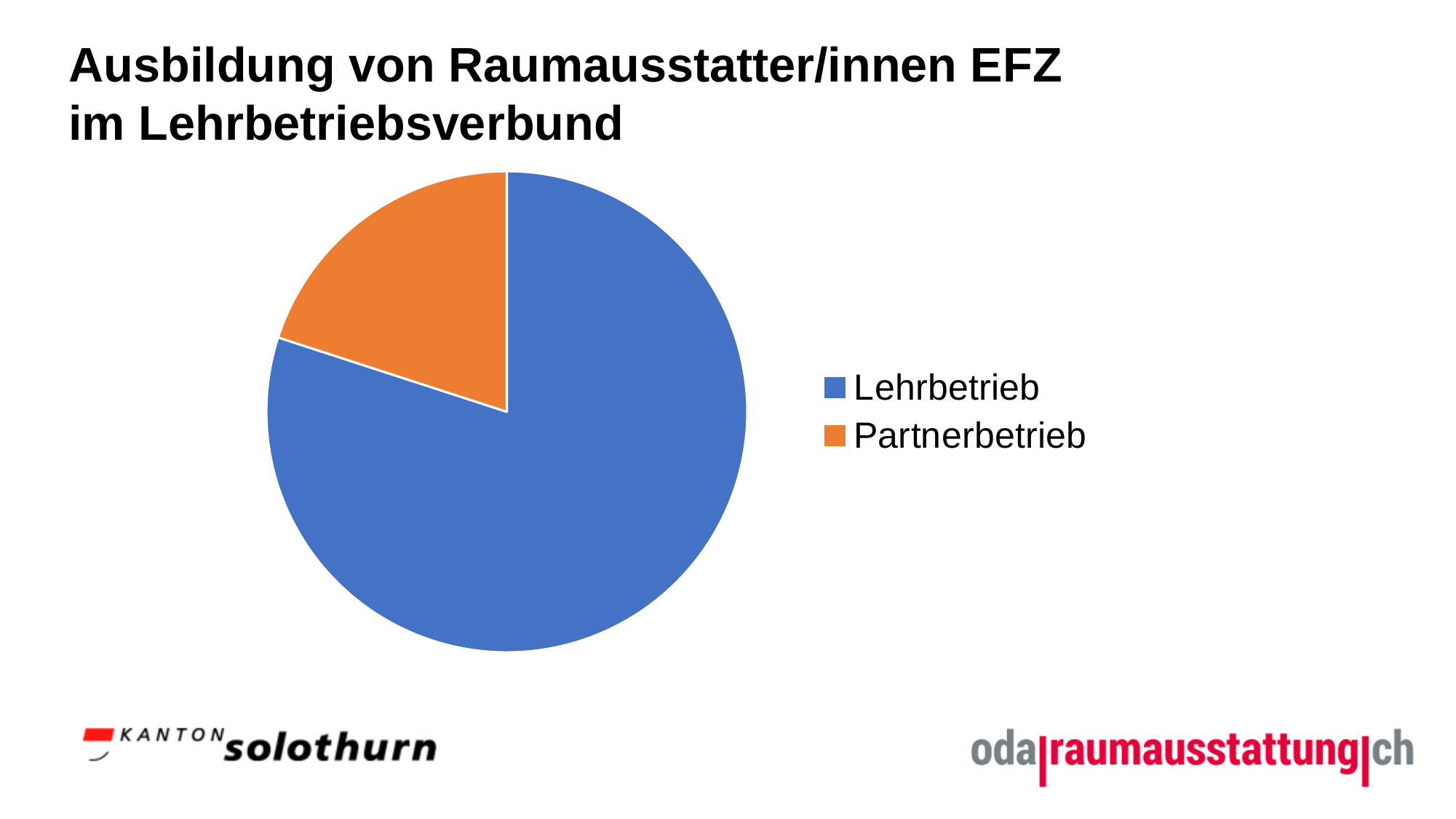
What kind of chart is shown on the slide? pie chart How many entries does the legend of the pie chart list? 2 Which colour represents Partnerbetrieb in the pie chart? orange Which category has the smallest slice in the pie chart? Partnerbetrieb How many slices does the pie chart have? 2 Which slice is larger, Lehrbetrieb or Partnerbetrieb? Lehrbetrieb Which category is shown in blue in the pie chart? Lehrbetrieb Which category has the largest slice in the pie chart? Lehrbetrieb